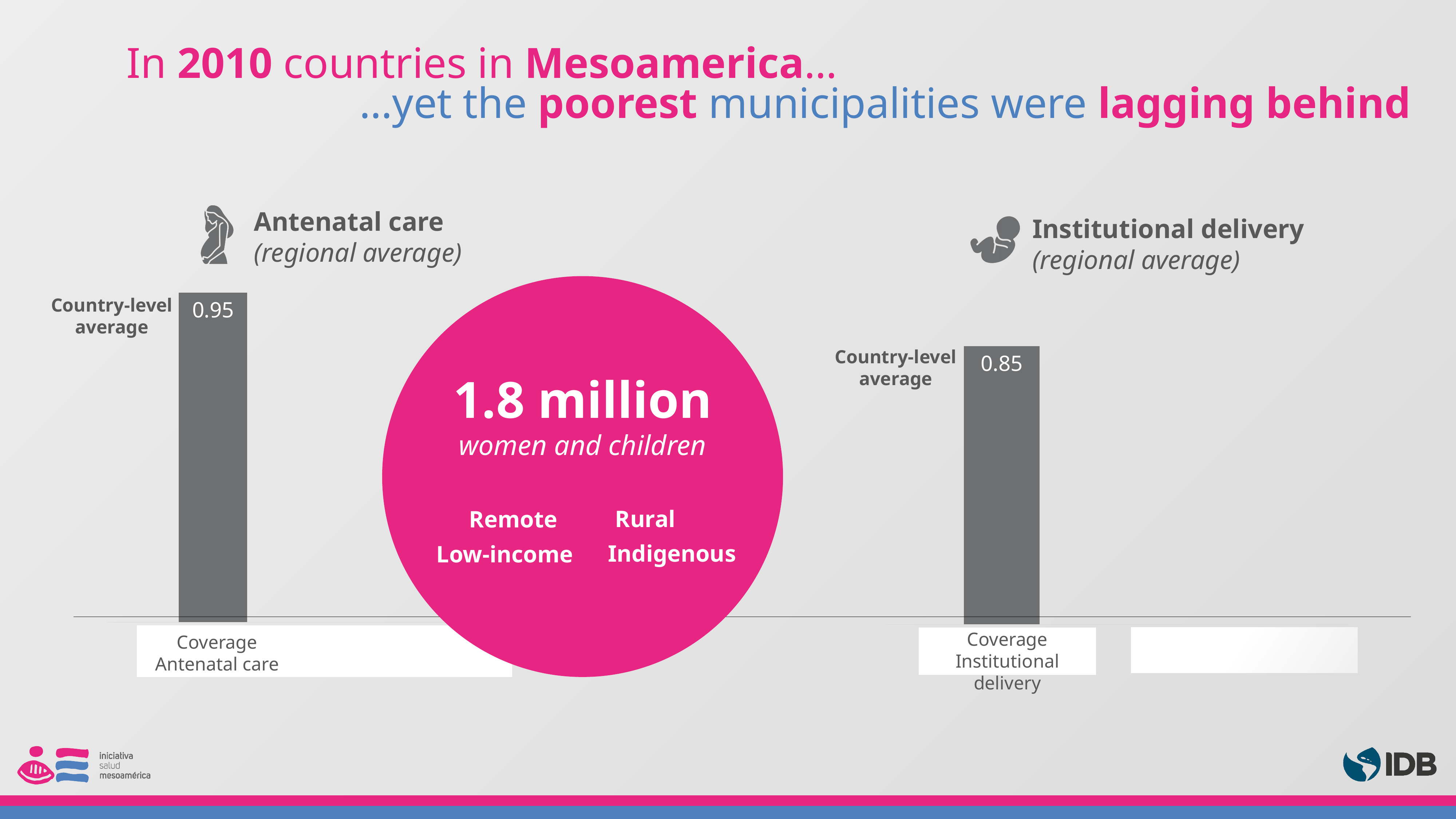
In the Institutional delivery chart, what is the value of the Country-level average bar? 0.85 Which is larger: the Country-level average in the Antenatal care chart or in the Institutional delivery chart? Antenatal care In the Antenatal care chart, what is the label to the left of the bar? Country-level average In the Antenatal care chart, what is the category label under the bar? Coverage Antenatal care Which chart on the slide has the lower Country-level average value? Institutional delivery What is the difference between the Country-level average in the Antenatal care chart (0.95) and in the Institutional delivery chart (0.85)? 0.10 What kind of chart is the Institutional delivery chart? Bar chart What kind of chart is the Antenatal care chart? Bar chart In the Institutional delivery chart, what is the category label under the bar? Coverage Institutional delivery In the Antenatal care chart, what is the value of the Country-level average bar? 0.95